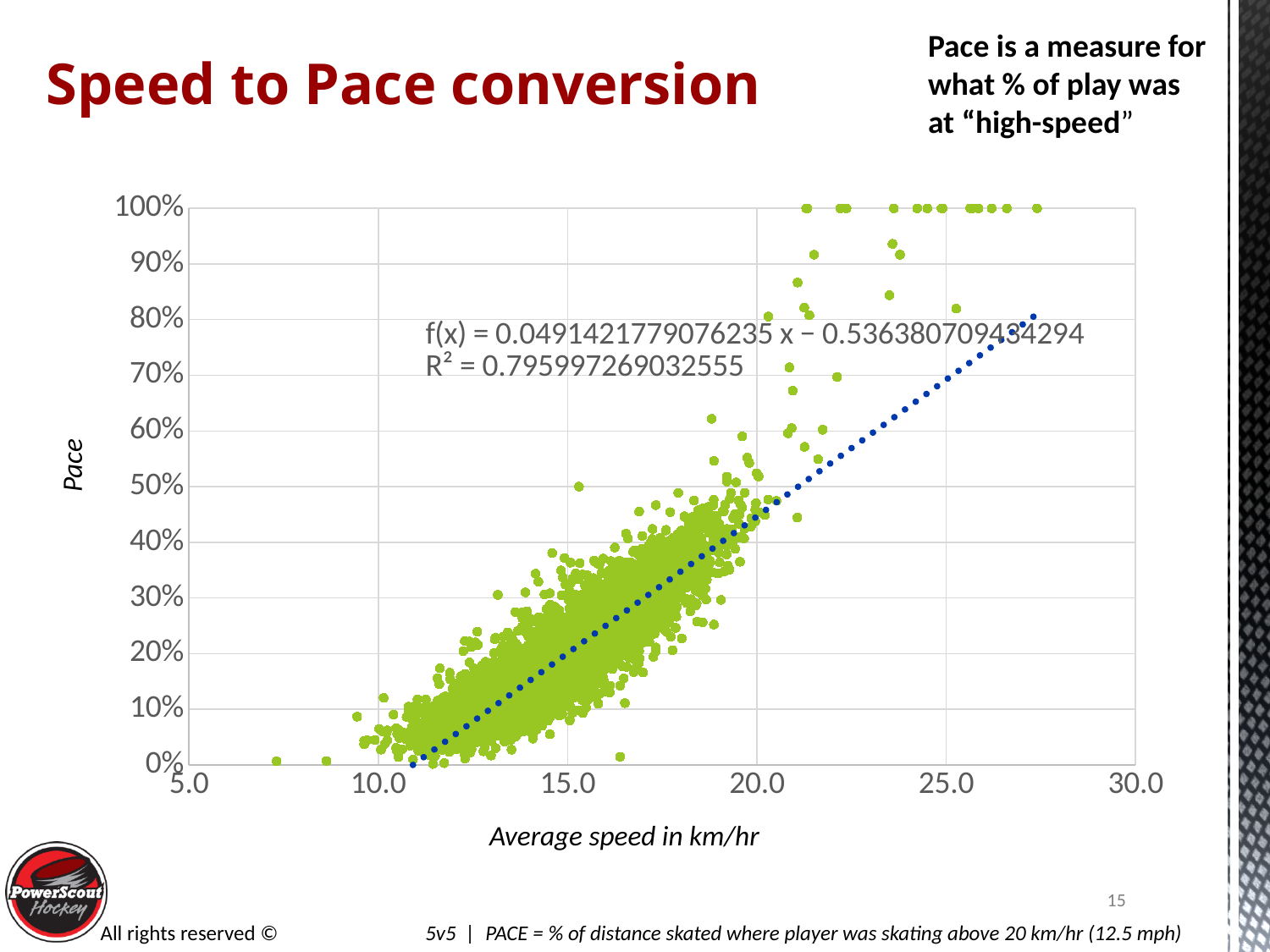
What is the intercept of the trendline equation shown on the chart? −0.536380709434294 What is the highest value labelled on the y axis of the chart? 100% What is the slope of the trendline equation shown on the chart? 0.0491421779076235 What is the trendline equation printed on the chart? f(x) = 0.0491421779076235 x − 0.536380709434294 As average speed increases along the x axis, does pace generally rise or fall? rise Is the R² value printed on the chart greater or less than 0.5? greater What kind of chart is shown on the slide? scatter chart What is the lowest value labelled on the x axis of the chart? 5.0 What R² value is printed on the chart for the trendline? 0.795997269032555 What is the title of the x axis of the chart? Average speed in km/hr What is the title of the y axis of the chart? Pace What is the highest value labelled on the x axis of the chart? 30.0